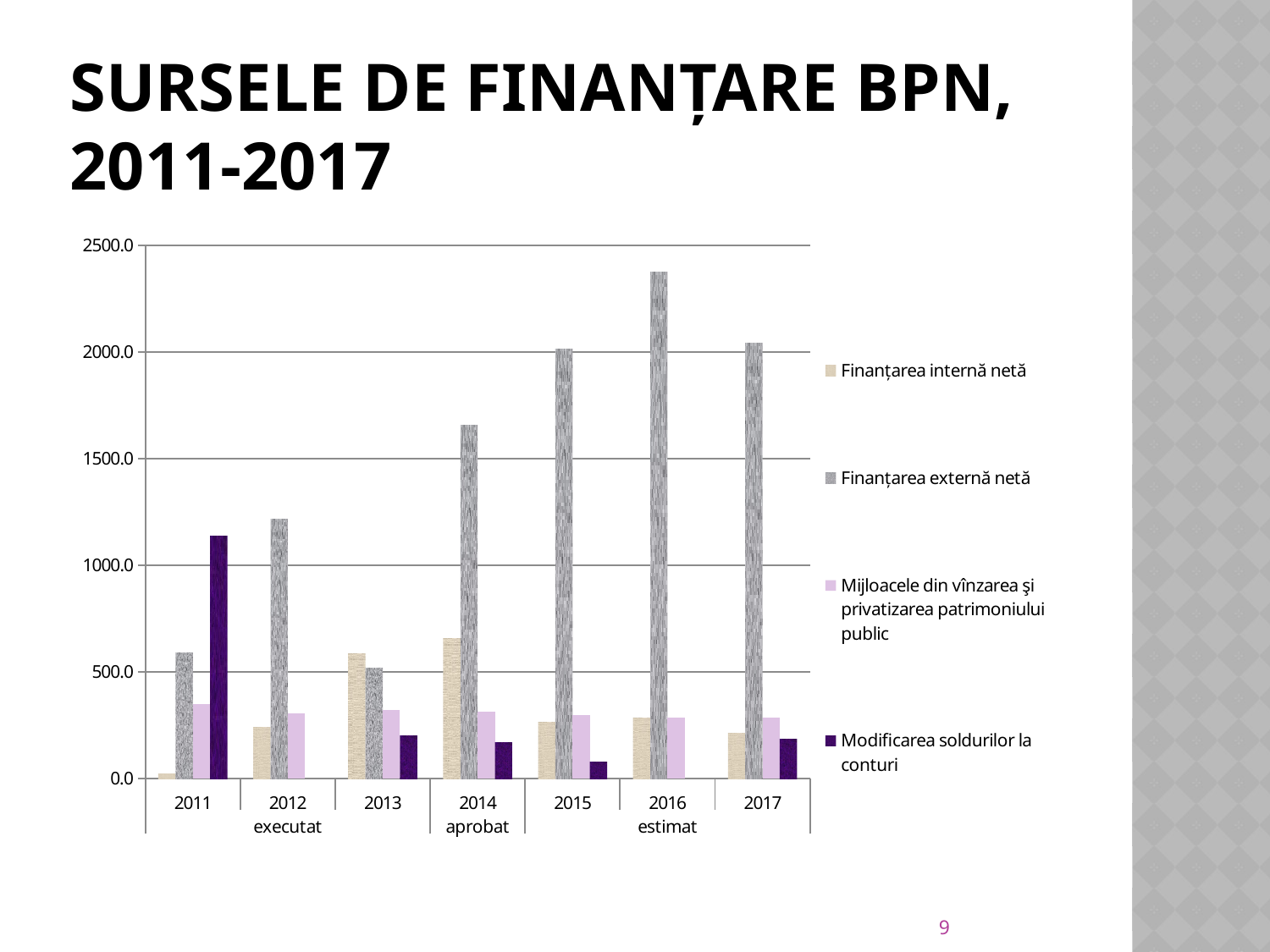
Is the value of Modificarea soldurilor la conturi in 2011 greater or less than 1000.0? greater What kind of chart is shown on the slide? bar chart Does Finanțarea externă netă rise or fall from 2014 to 2016? rise Is the value of Finanțarea externă netă in 2016 greater or less than 2000.0? greater In which year is Modificarea soldurilor la conturi highest? 2011 Which is larger: Finanțarea externă netă in 2014 or in 2012? 2014 Is the value of Finanțarea externă netă in 2011 greater or less than 1000.0? less What is the title of the chart slide? SURSELE DE FINANȚARE BPN, 2011-2017 In 2011, which is larger: Modificarea soldurilor la conturi or Finanțarea externă netă? Modificarea soldurilor la conturi How many years are shown on the x axis? 7 In which year is Finanțarea externă netă highest? 2016 How many series does the legend list? 4